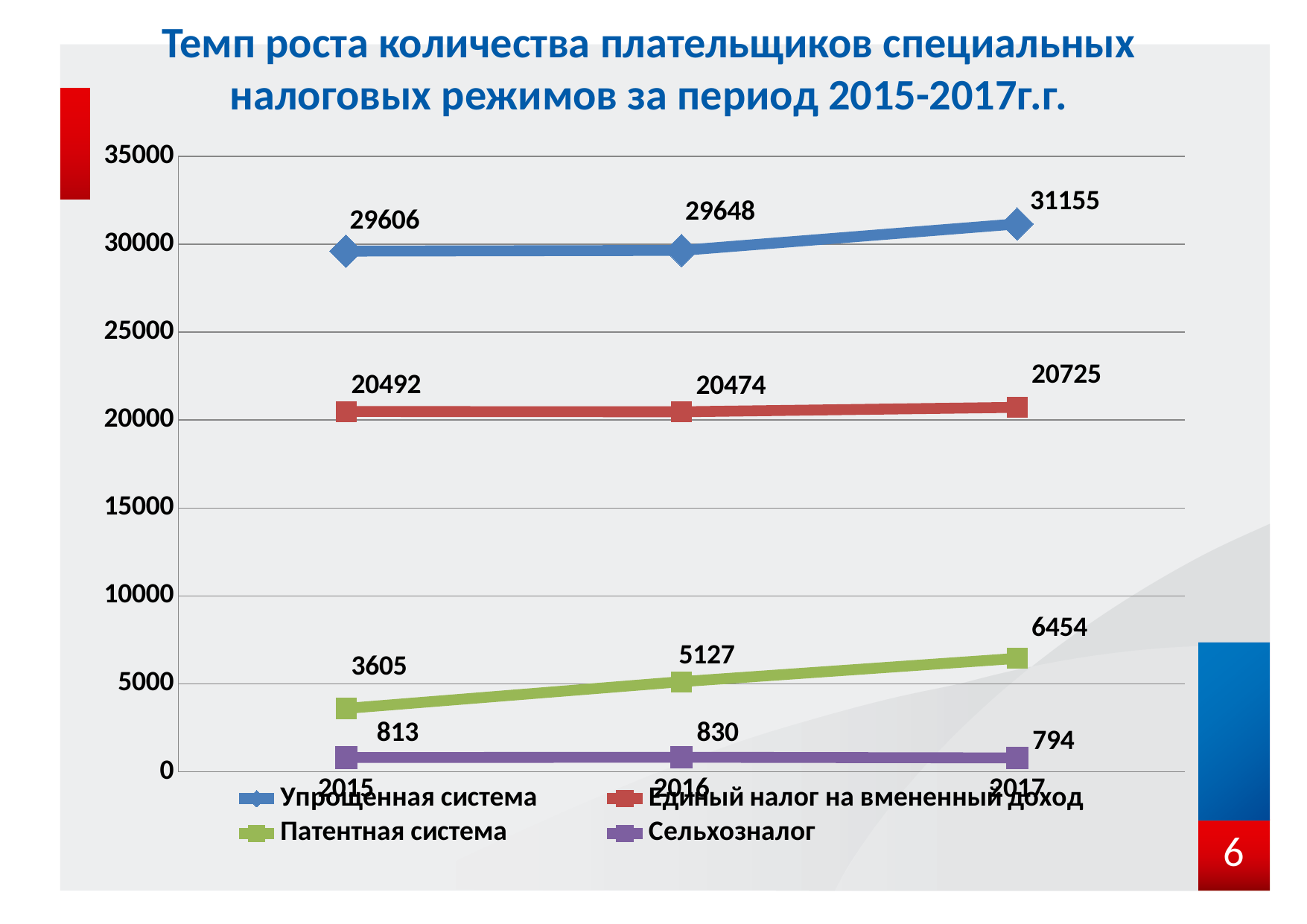
What is the difference between the Патентная система values in 2017 and 2015? 2849 What kind of chart is shown on the slide? line chart What is the value for Упрощенная система in 2017? 31155 How many years are shown on the x axis? 3 In which year is the value for Патентная система highest? 2017 What is the value for Сельхозналог in 2015? 813 What is the value for Патентная система in 2016? 5127 How many series does the legend list? 4 Is the value for Единый налог на вмененный доход in 2017 greater or less than 25000? less In which year is the value for Сельхозналог lowest? 2017 Does the value for Патентная система rise or fall from 2015 to 2017? rise Which is larger in 2016: Упрощенная система or Единый налог на вмененный доход? Упрощенная система